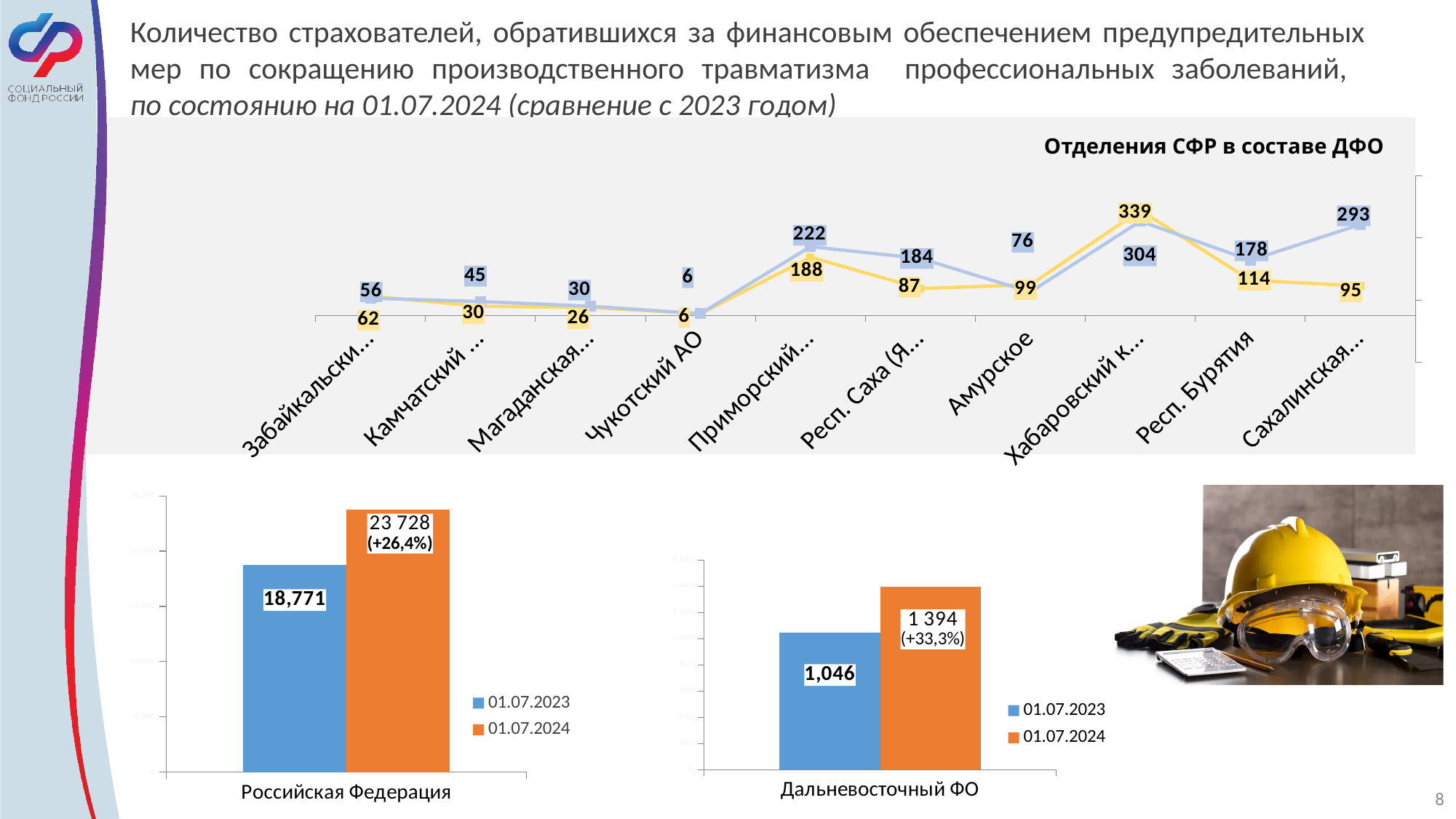
In the chart titled "Отделения СФР в составе ДФО", what is the difference between the blue line value (178) and the yellow line value (114) for Респ. Бурятия? 64 In the bar chart for Российская Федерация, what is the value for 01.07.2023? 18,771 In the chart titled "Отделения СФР в составе ДФО", what is the value of the yellow line for Респ. Бурятия? 114 In the bar chart for Дальневосточный ФО, what is the value for 01.07.2023? 1,046 In the chart titled "Отделения СФР в составе ДФО", what is the value of the blue line for Чукотский АО? 6 How many categories are shown on the x axis of the chart titled "Отделения СФР в составе ДФО"? 10 In the chart titled "Отделения СФР в составе ДФО", which category has the highest value on the blue line? Хабаровский к... In the bar chart for Российская Федерация, what is the value for 01.07.2024? 23 728 What kind of chart is the chart for Российская Федерация at the bottom left of the slide? bar chart How many series does the legend of the bar chart for Дальневосточный ФО list? 2 What kind of chart is the chart titled "Отделения СФР в составе ДФО"? line chart In the bar chart for Дальневосточный ФО, which is larger: the value for 01.07.2023 or for 01.07.2024? 01.07.2024